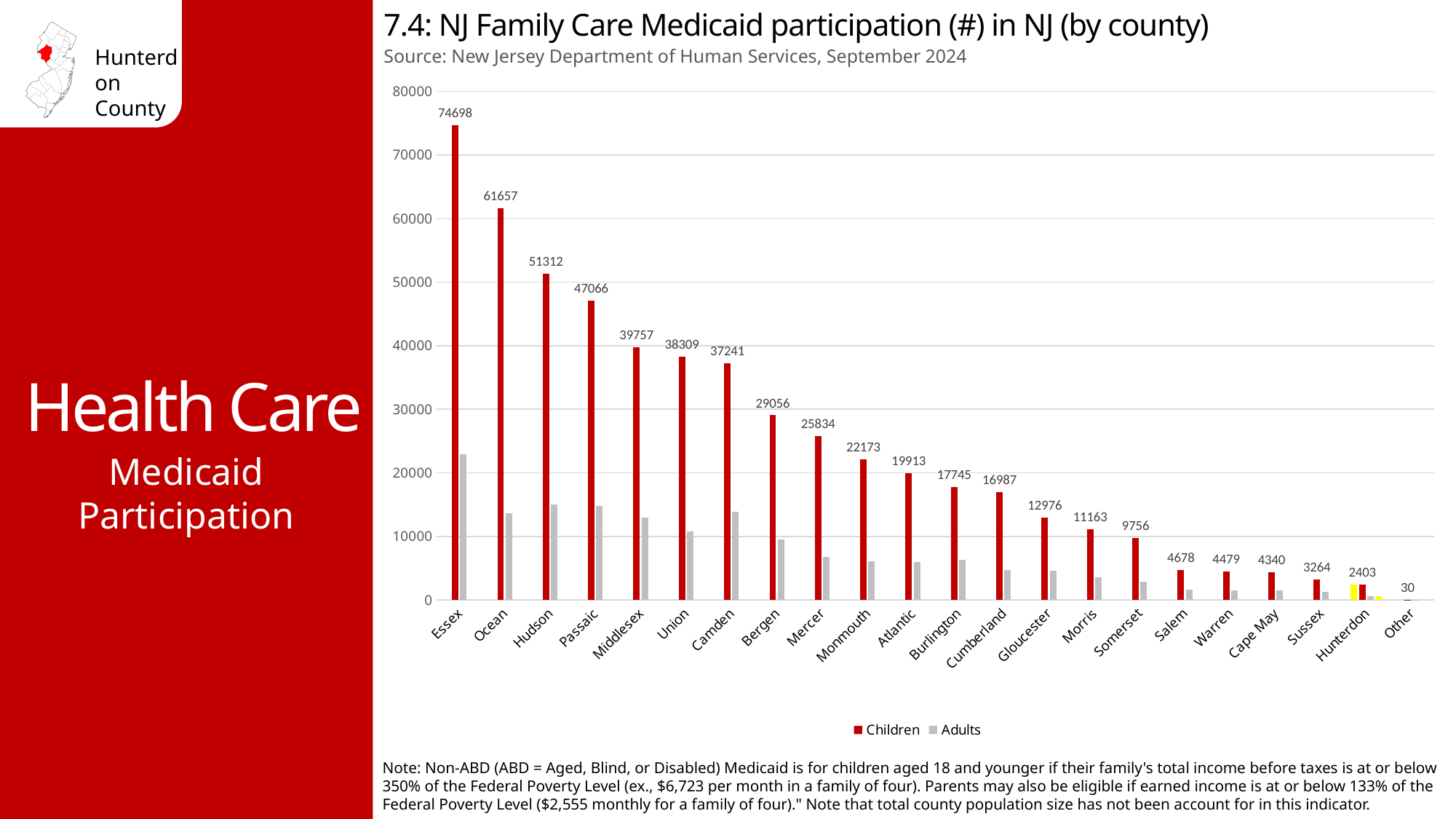
Which category has the lowest Children value? Other What is the Children value for Hunterdon? 2403 How many categories are shown on the x axis? 22 Is the Adults value for Essex greater or less than 20000? greater Which has a larger Children value, Hudson or Passaic? Hudson How many series does the legend list? 2 What is the Children value for Essex? 74698 What is the difference between the Children values for Morris and Somerset? 1407 Is the Adults value for Ocean greater or less than 20000? less What kind of chart is shown? bar chart Which category has the highest Children value? Essex What is the difference between the Children values for Essex and Ocean? 13041